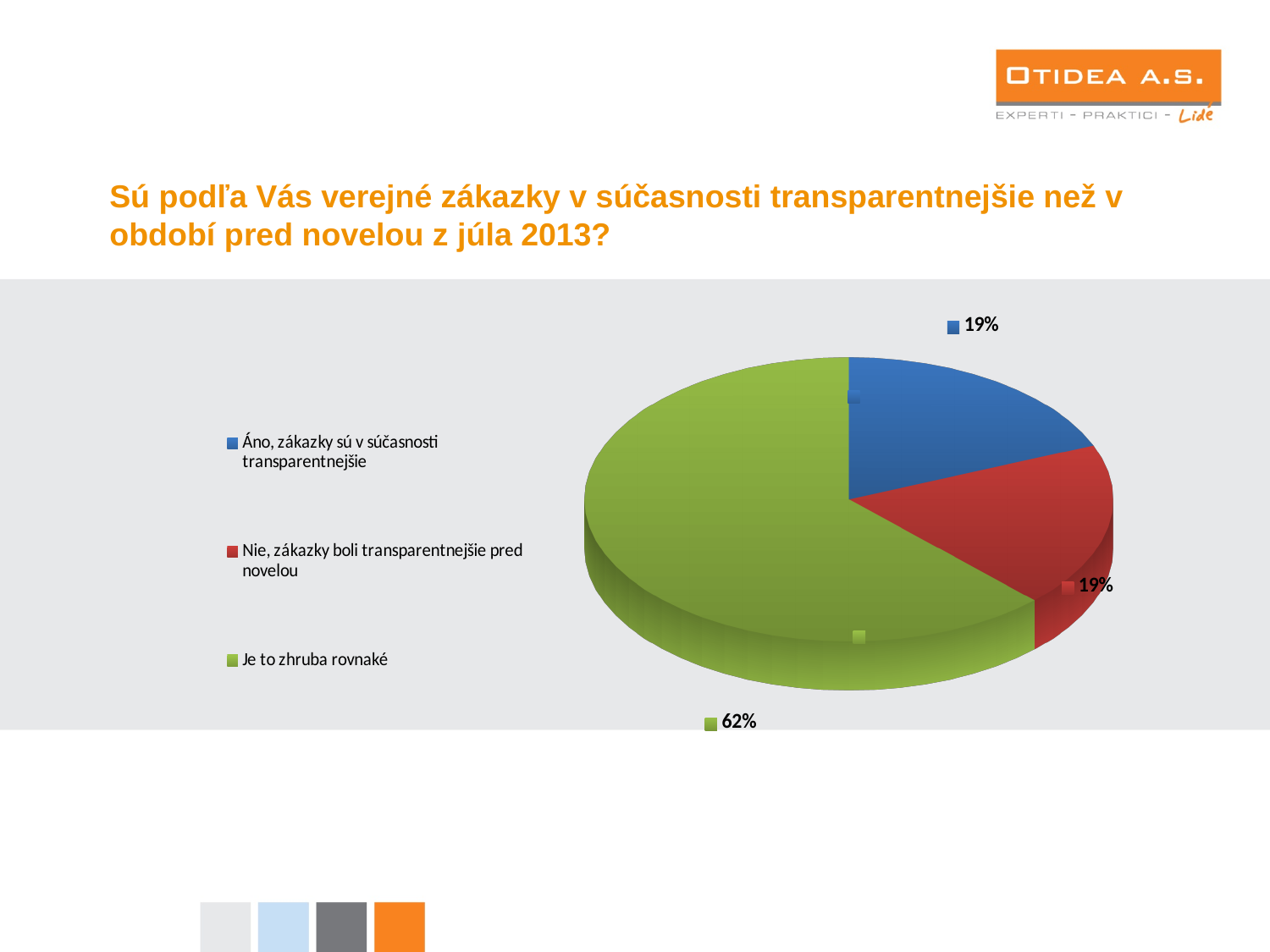
What kind of chart is shown on the slide? pie chart Which colour represents "Nie, zákazky boli transparentnejšie pred novelou" in the pie chart? red Which answer option has the largest share of the pie? Je to zhruba rovnaké What percentage of respondents answered "Je to zhruba rovnaké"? 62% Is the share for "Je to zhruba rovnaké" greater or less than 50%? greater What percentage of respondents answered "Áno, zákazky sú v súčasnosti transparentnejšie"? 19% What is the difference in percentage points between "Je to zhruba rovnaké" and "Áno, zákazky sú v súčasnosti transparentnejšie"? 43 percentage points How many entries does the legend of the pie chart list? 3 What percentage of respondents answered "Nie, zákazky boli transparentnejšie pred novelou"? 19% What share of the pie does the green slice represent? 62% How many slices does the pie chart have? 3 Which is larger: the share for "Je to zhruba rovnaké" or the share for "Nie, zákazky boli transparentnejšie pred novelou"? Je to zhruba rovnaké